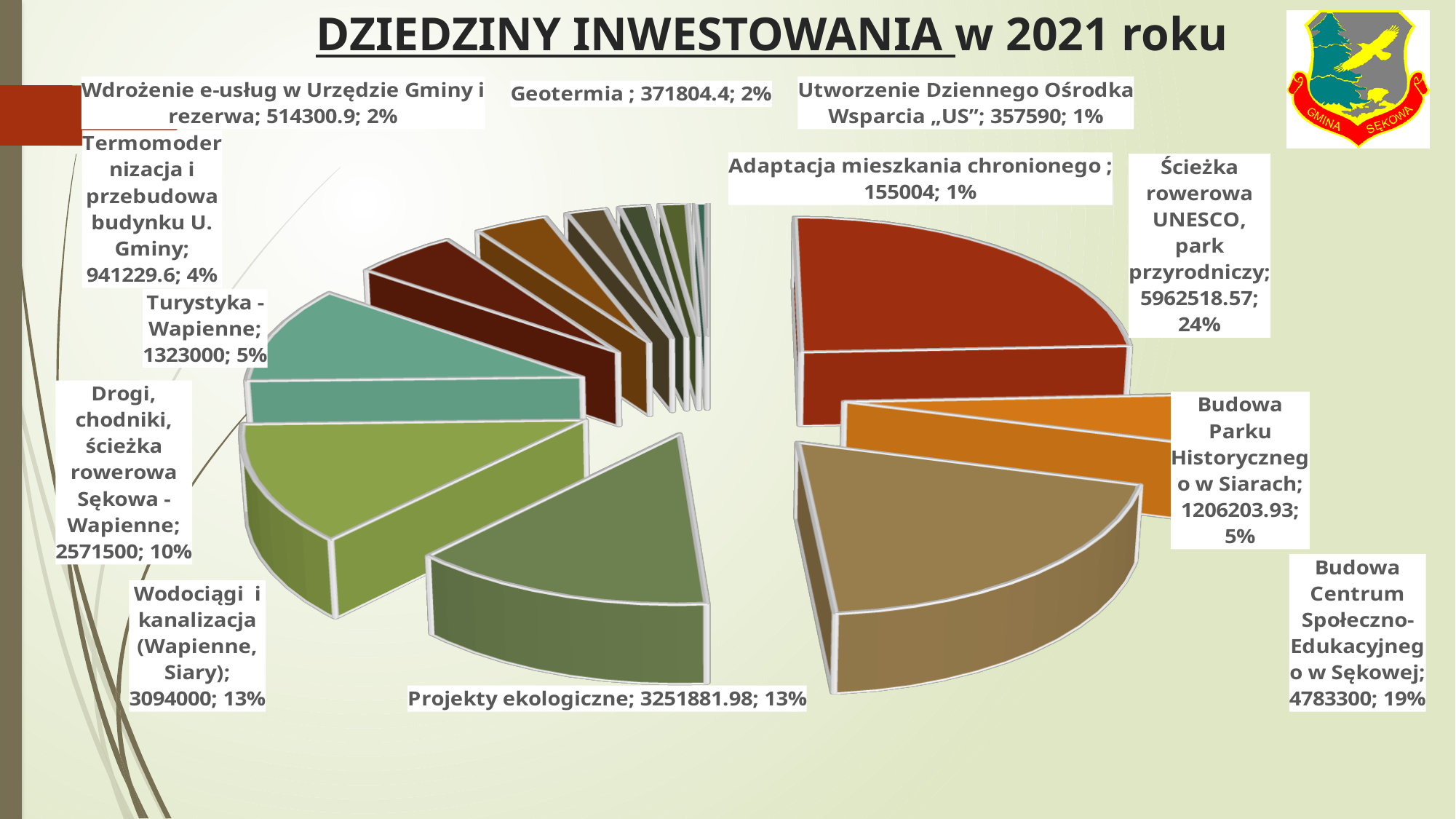
What is the difference between the values for Wodociągi i kanalizacja (Wapienne, Siary) and Turystyka - Wapienne? 1771000 How many slices does the pie chart have? 12 What kind of chart is shown on the slide? Pie chart Which category has the largest slice of the pie? Ścieżka rowerowa UNESCO, park przyrodniczy What is the value for Projekty ekologiczne? 3251881.98 Which category has the smallest slice of the pie? Adaptacja mieszkania chronionego What share of the pie does Budowa Centrum Społeczno-Edukacyjnego w Sękowej represent? 19% What share of the pie does Drogi, chodniki, ścieżka rowerowa Sękowa - Wapienne represent? 10% What is the title of the chart? DZIEDZINY INWESTOWANIA w 2021 roku Which is larger, the value for Termomodernizacja i przebudowa budynku U. Gminy or the value for Wdrożenie e-usług w Urzędzie Gminy i rezerwa? Termomodernizacja i przebudowa budynku U. Gminy What is the value for Budowa Parku Historycznego w Siarach? 1206203.93 What is the value for Geotermia? 371804.4